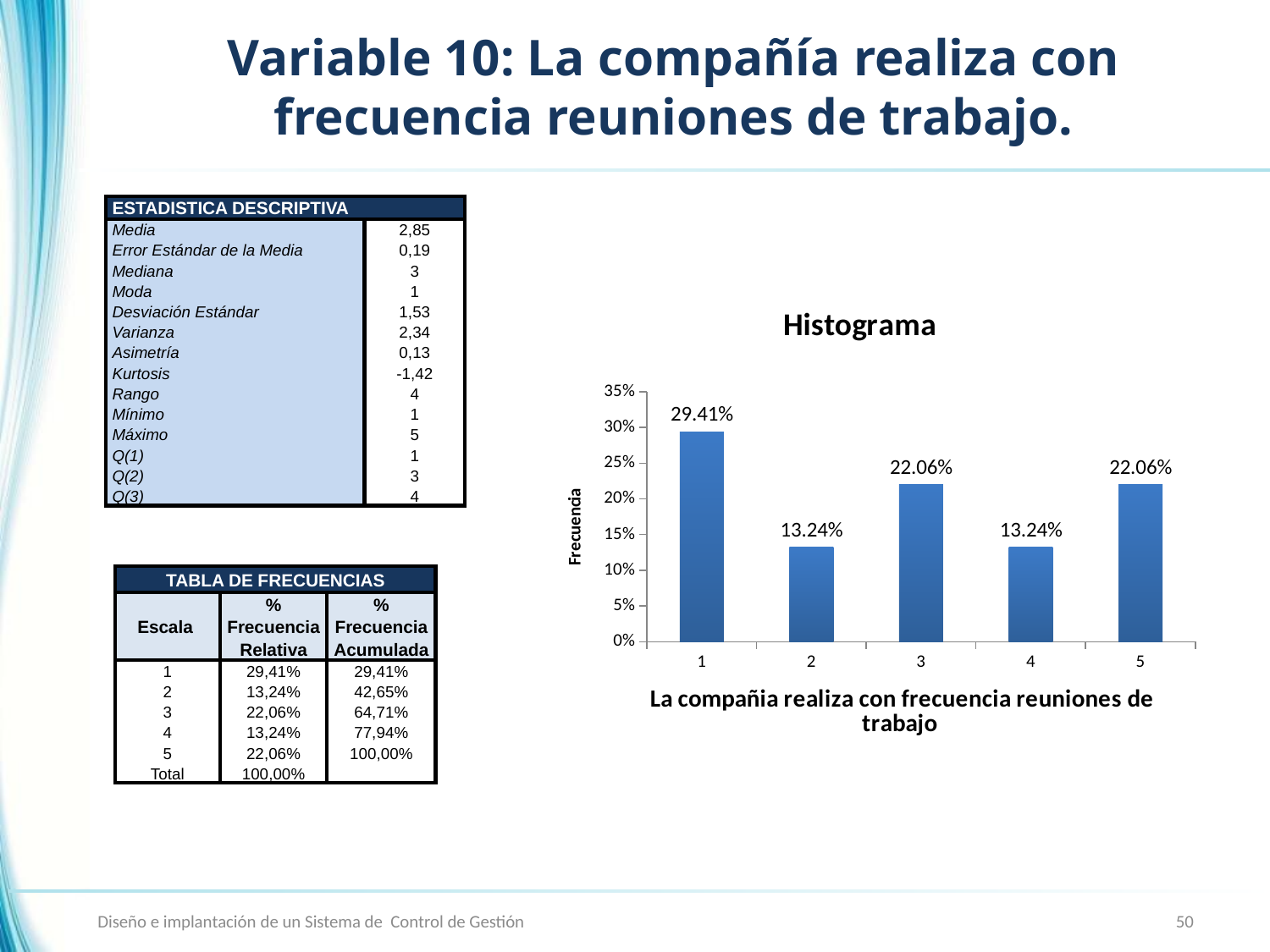
What is the label of the y axis of the histogram? Frecuencia Which is larger in the histogram, the value for category 2 or the value for category 5? 5 What is the title of the chart? Histograma What is the value for category 1 in the histogram? 29.41% How many categories are shown on the x axis of the histogram? 5 What kind of chart is the histogram? bar chart What is the difference between the values for category 3 and category 4 in the histogram? 8.82% What is the difference between the values for category 1 and category 2 in the histogram? 16.17% What is the value for category 4 in the histogram? 13.24% What is the value for category 3 in the histogram? 22.06% Is the value for category 1 in the histogram greater or less than 25%? greater Which category has the highest value in the histogram? 1